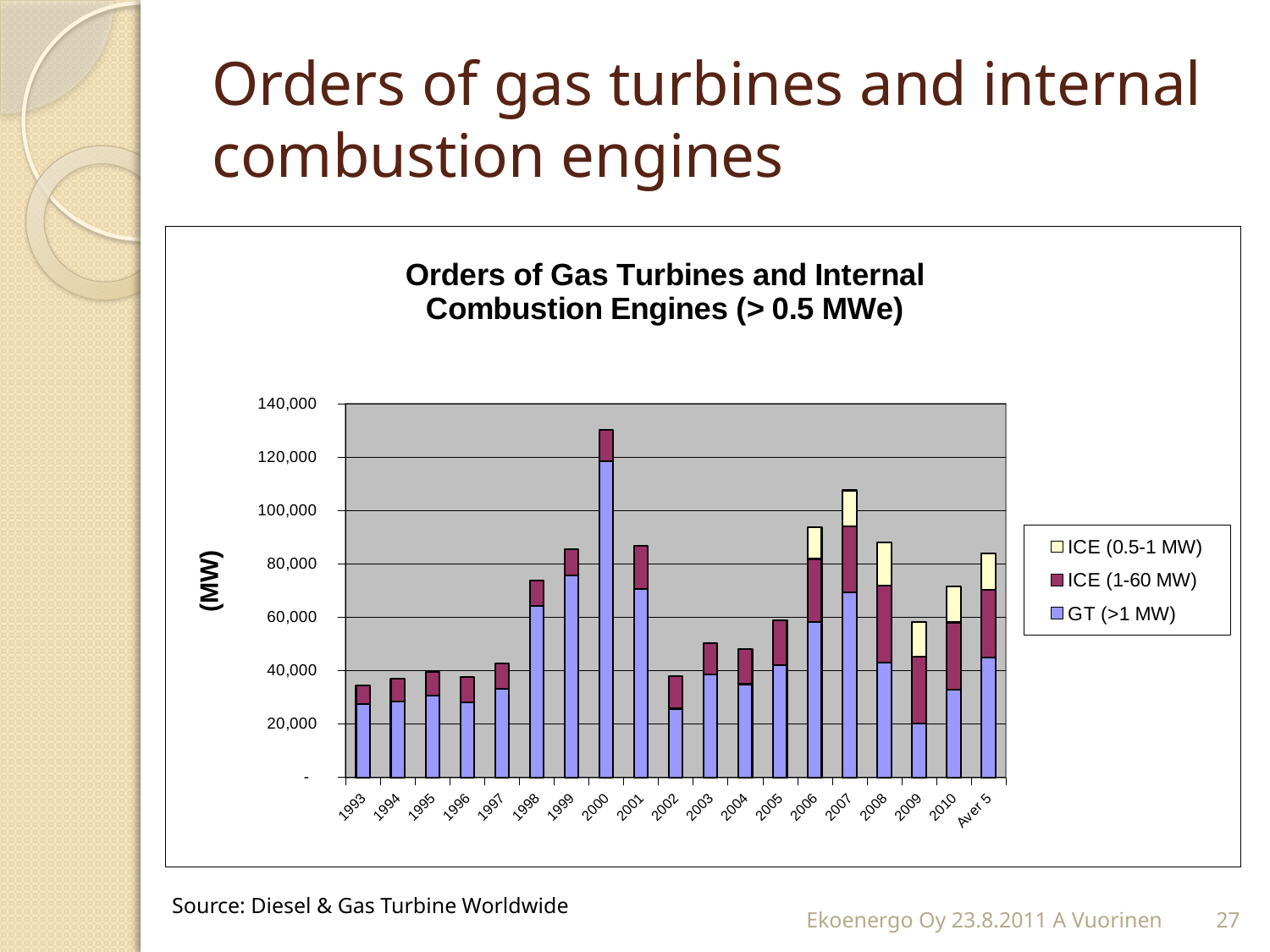
Which series is shown in the lightest (yellow) colour in the legend? ICE (0.5-1 MW) What label is shown on the y axis? (MW) Do the total bars rise or fall from 1993 to 1997? rise Is the total value for 2007 greater or less than 100,000? greater Is the GT (>1 MW) value for 2000 greater or less than 100,000? greater Which year has the tallest total bar? 2000 Is the total value for 2000 greater or less than 120,000? greater Which has the larger total bar, 2006 or 2007? 2007 How many categories are shown along the x axis? 19 What kind of chart is shown on the slide? Stacked bar chart How many series does the legend list? 3